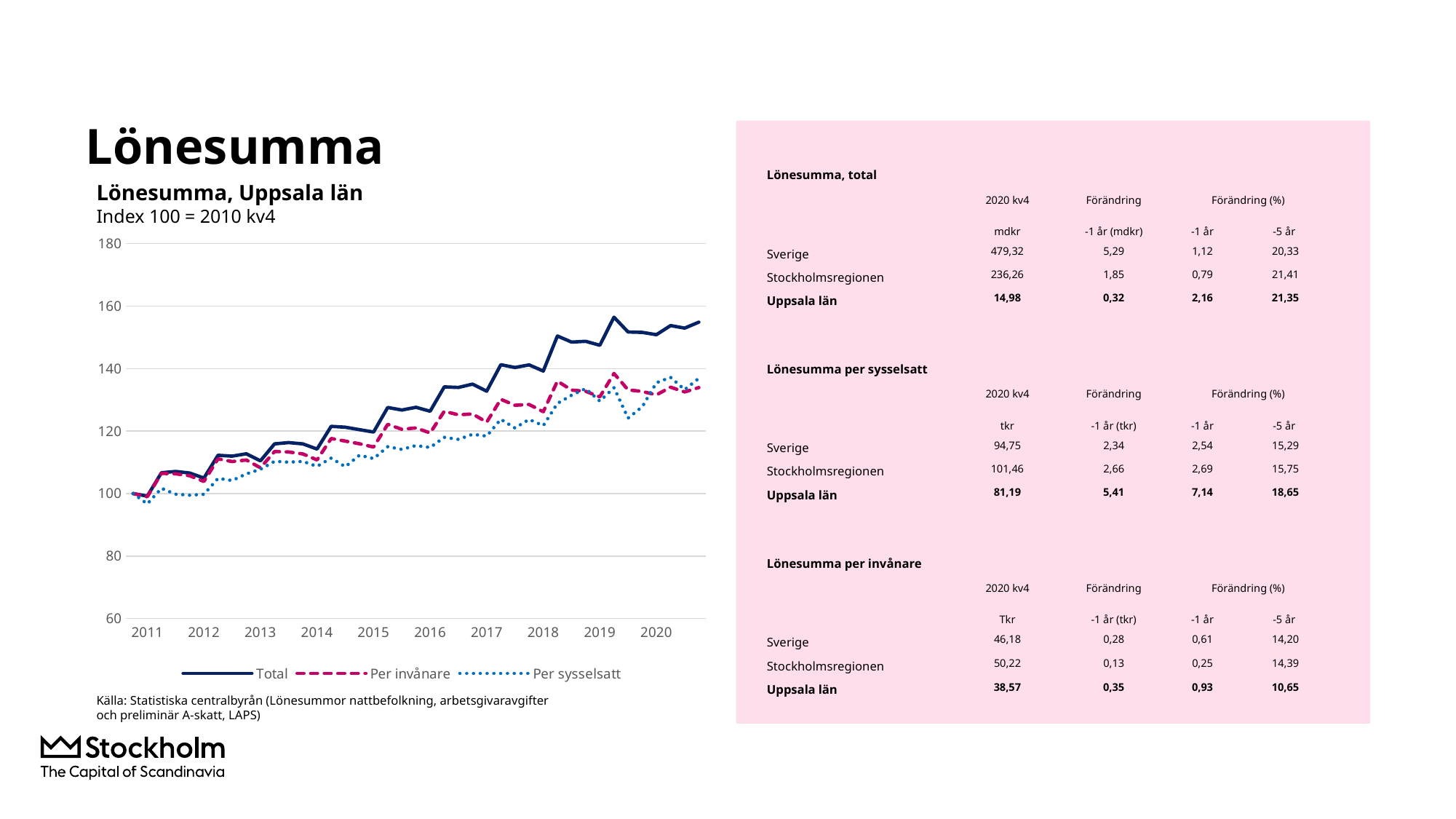
How many series does the legend of the chart list? 3 Is the value of the Per invånare series at the end of 2020 greater or less than 120? greater Does the Total series rise or fall over the period shown on the x axis? Rise Which series has the highest value at the end of the period shown? Total Is the value of the Per sysselsatt series at the start of 2011 greater or less than 120? less At the end of 2020, which series has the higher value: Total or Per invånare? Total Which series are listed in the legend of the chart? Total, Per invånare, Per sysselsatt What kind of chart is shown on the slide? Line chart Is the value of the Total series at the end of 2020 greater or less than 140? greater What is the title of the chart? Lönesumma, Uppsala län How many year labels are shown on the x axis of the chart? 10